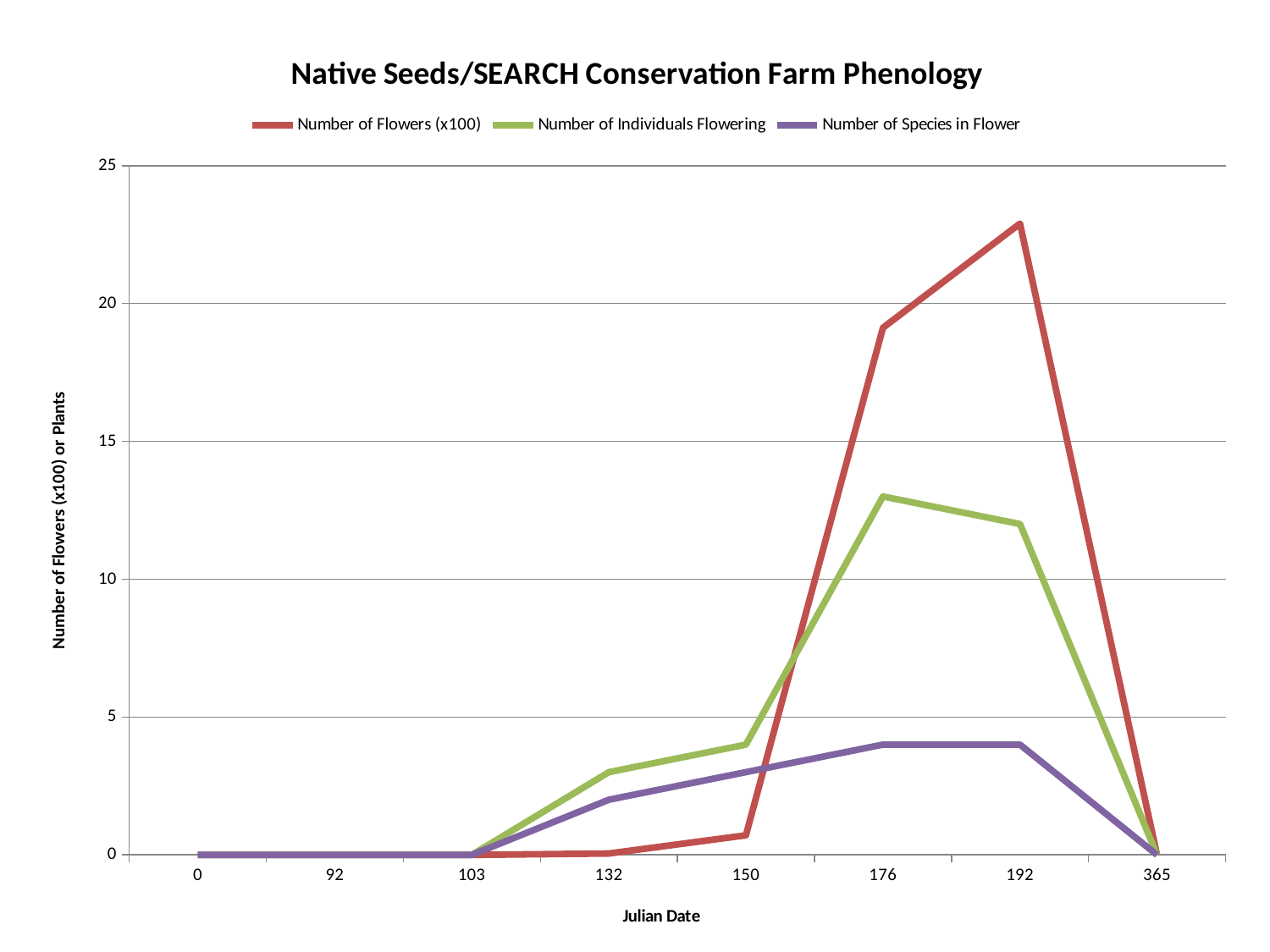
Is the value of Number of Individuals Flowering at Julian Date 176 greater or less than 10? greater What kind of chart is shown on the slide? line chart At Julian Date 150, which is larger: Number of Individuals Flowering or Number of Flowers (x100)? Number of Individuals Flowering How many Julian Date points are labelled on the x axis? 8 How many series does the legend list? 3 At which Julian Date does Number of Flowers (x100) reach its highest value? 192 Is the value of Number of Flowers (x100) at Julian Date 192 greater or less than 20? greater Does Number of Flowers (x100) rise or fall between Julian Date 192 and 365? fall At Julian Date 192, which is larger: Number of Flowers (x100) or Number of Individuals Flowering? Number of Flowers (x100) Is the value of Number of Species in Flower at Julian Date 176 greater or less than 5? less What is the value of Number of Species in Flower at Julian Date 365? 0 At which Julian Date does Number of Individuals Flowering reach its highest value? 176